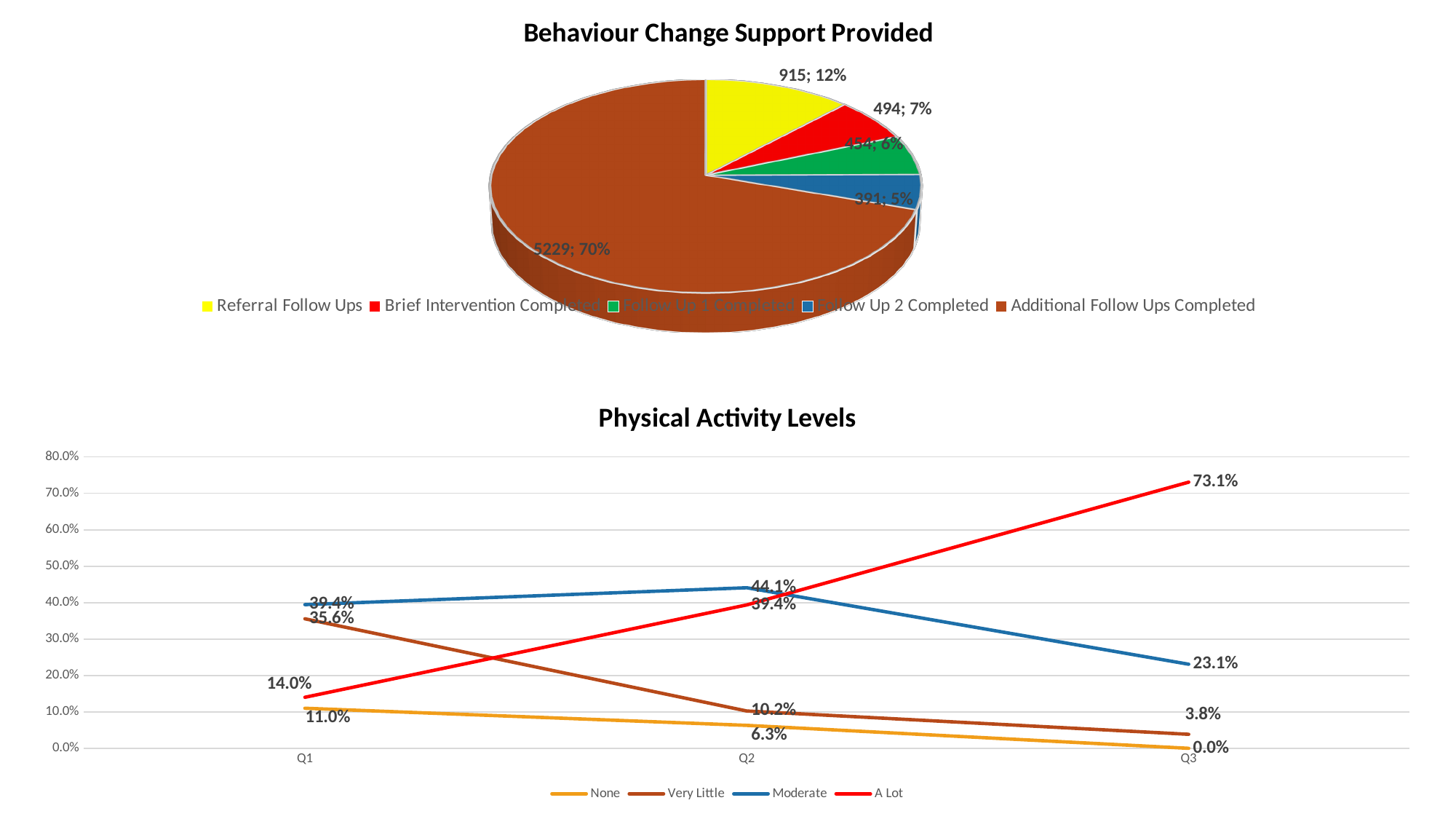
In the Physical Activity Levels chart, what is the value for Moderate in Q2? 44.1% In the Behaviour Change Support Provided pie chart, which category has the smallest slice? Follow Up 2 Completed In the Physical Activity Levels chart, what is the difference between the A Lot value in Q3 and the A Lot value in Q1? 59.1% In the Physical Activity Levels chart, does the Very Little series rise or fall from Q1 to Q3? Fall In the Behaviour Change Support Provided pie chart, what share of the pie is Referral Follow Ups? 12% In the Behaviour Change Support Provided pie chart, what is the difference between the Brief Intervention Completed value and the Follow Up 1 Completed value? 40 In the Physical Activity Levels chart, what is the value for A Lot in Q3? 73.1% In the Behaviour Change Support Provided pie chart, what value and share are shown for Additional Follow Ups Completed? 5229; 70% In the Physical Activity Levels chart, which is larger in Q1: Moderate or A Lot? Moderate In the Physical Activity Levels chart, how many series does the legend list? 4 In the Behaviour Change Support Provided pie chart, how many categories does the legend list? 5 What kind of chart is Physical Activity Levels? Line chart